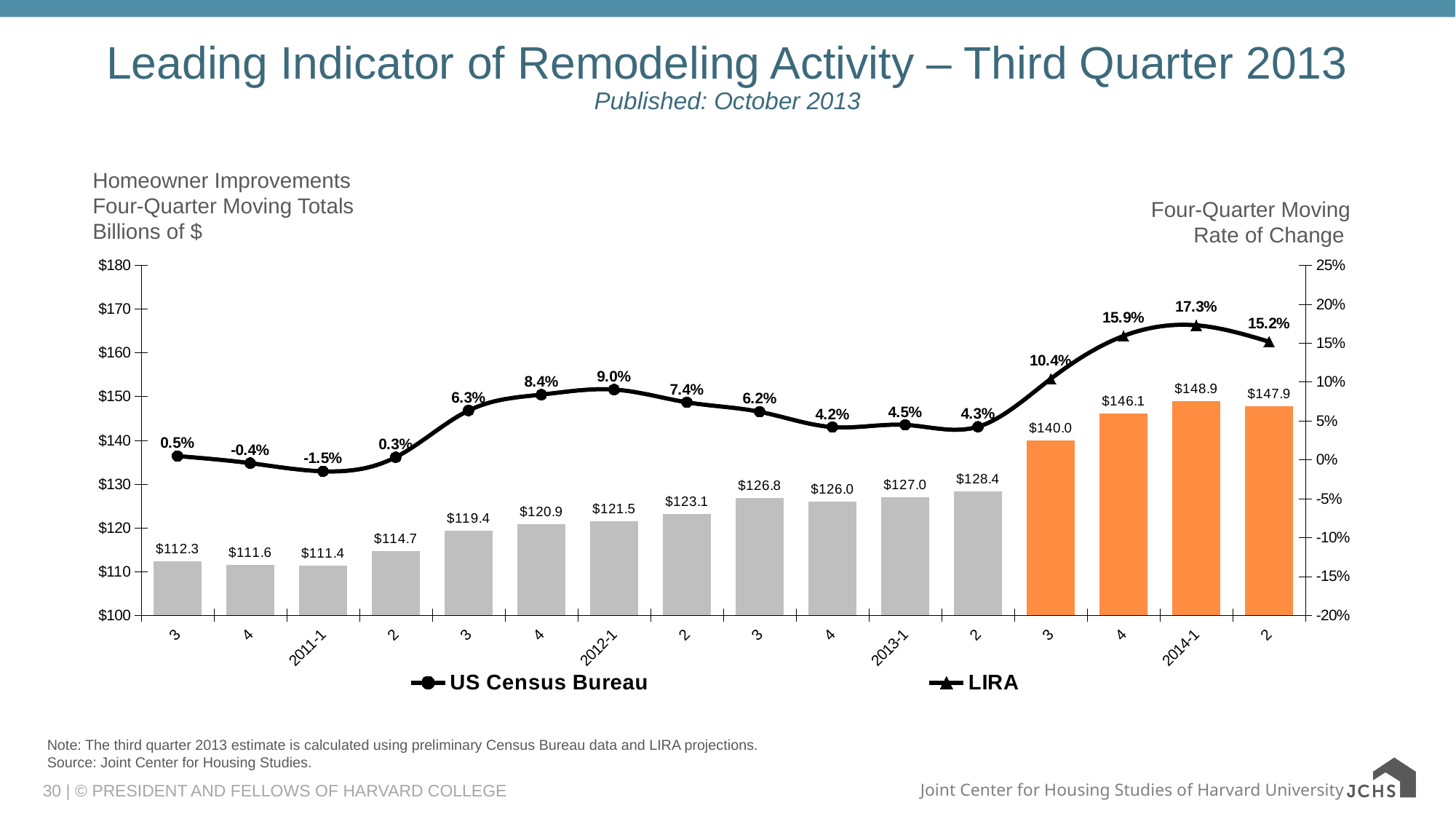
What is the highest four-quarter moving rate of change shown on the line? 17.3% Which quarter has the lowest four-quarter moving total bar? 2011-1 ($111.4) What is the difference between the four-quarter moving totals for 2014-1 and 2013-1? $21.9 What is the four-quarter moving total for 2012-1? $121.5 Which is larger, the four-quarter moving total for the third quarter of 2012 ($126.8) or the fourth quarter of 2012 ($126.0)? Third quarter of 2012 How many quarterly bars are plotted on the chart? 16 What is the lowest four-quarter moving rate of change shown on the line? -1.5% What is the four-quarter moving rate of change for 2013-1? 4.5% What kind of chart is shown on the slide? Combined bar and line chart Which quarter has the highest four-quarter moving total bar? 2014-1 ($148.9) Does the four-quarter moving rate of change rise or fall from 2013-2 to 2014-1? Rise How many series does the legend list? 2